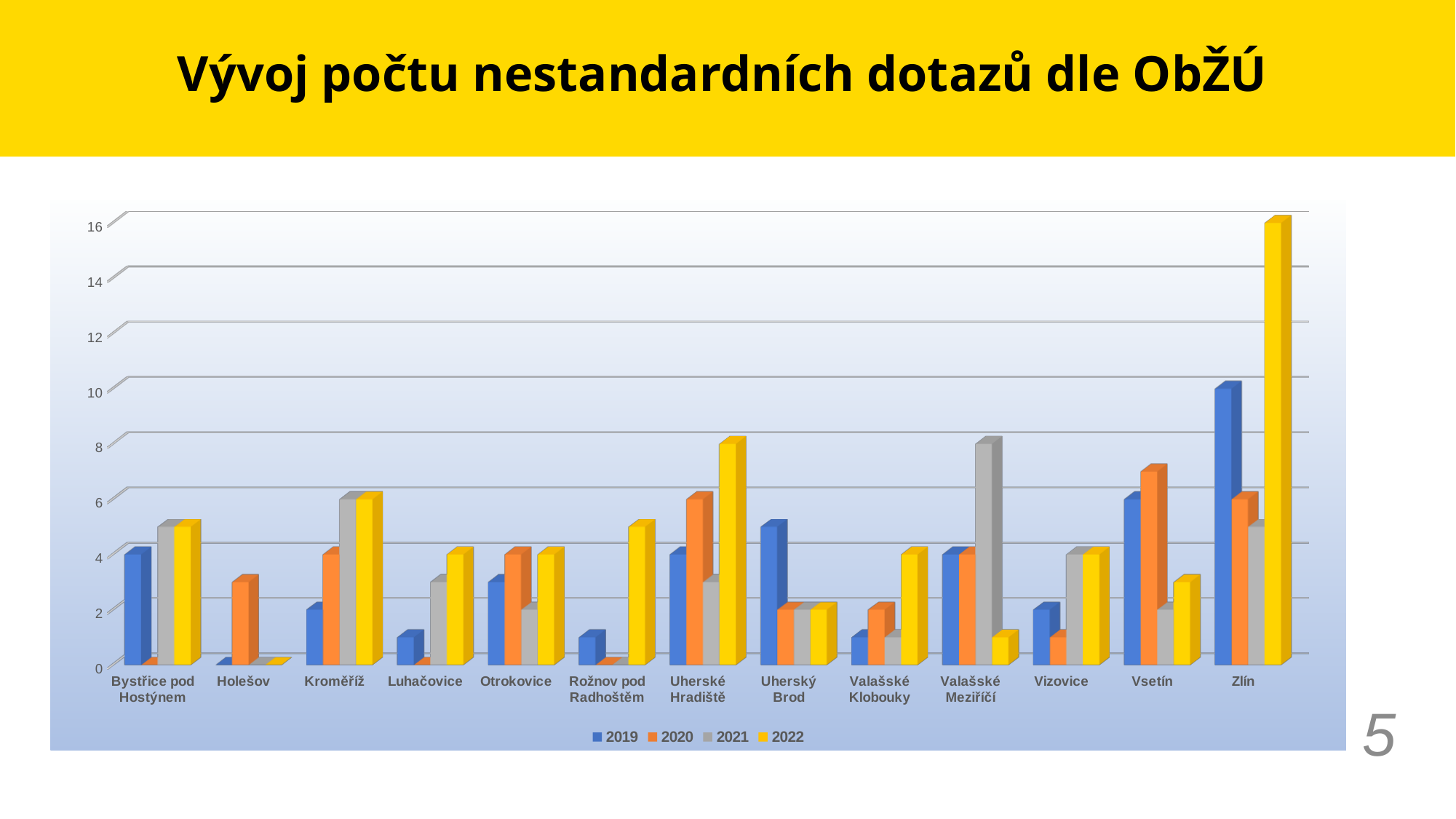
What is the value for Uherské Hradiště in 2022? 8 Is the value for Vsetín in 2020 greater or less than 6? greater What is the value for Zlín in 2019? 10 Which municipality has the highest value for 2022? Zlín How many categories (municipalities) are shown on the x axis? 13 What is the title of the chart slide? Vývoj počtu nestandardních dotazů dle ObŽÚ What is the value for Holešov in 2019? 0 What kind of chart is shown on the slide? bar chart What is the difference between the 2022 and 2019 values for Zlín? 6 How many series does the legend list? 4 Which is larger: the 2019 value for Zlín or the 2019 value for Vsetín? Zlín What is the value for Zlín in 2022? 16